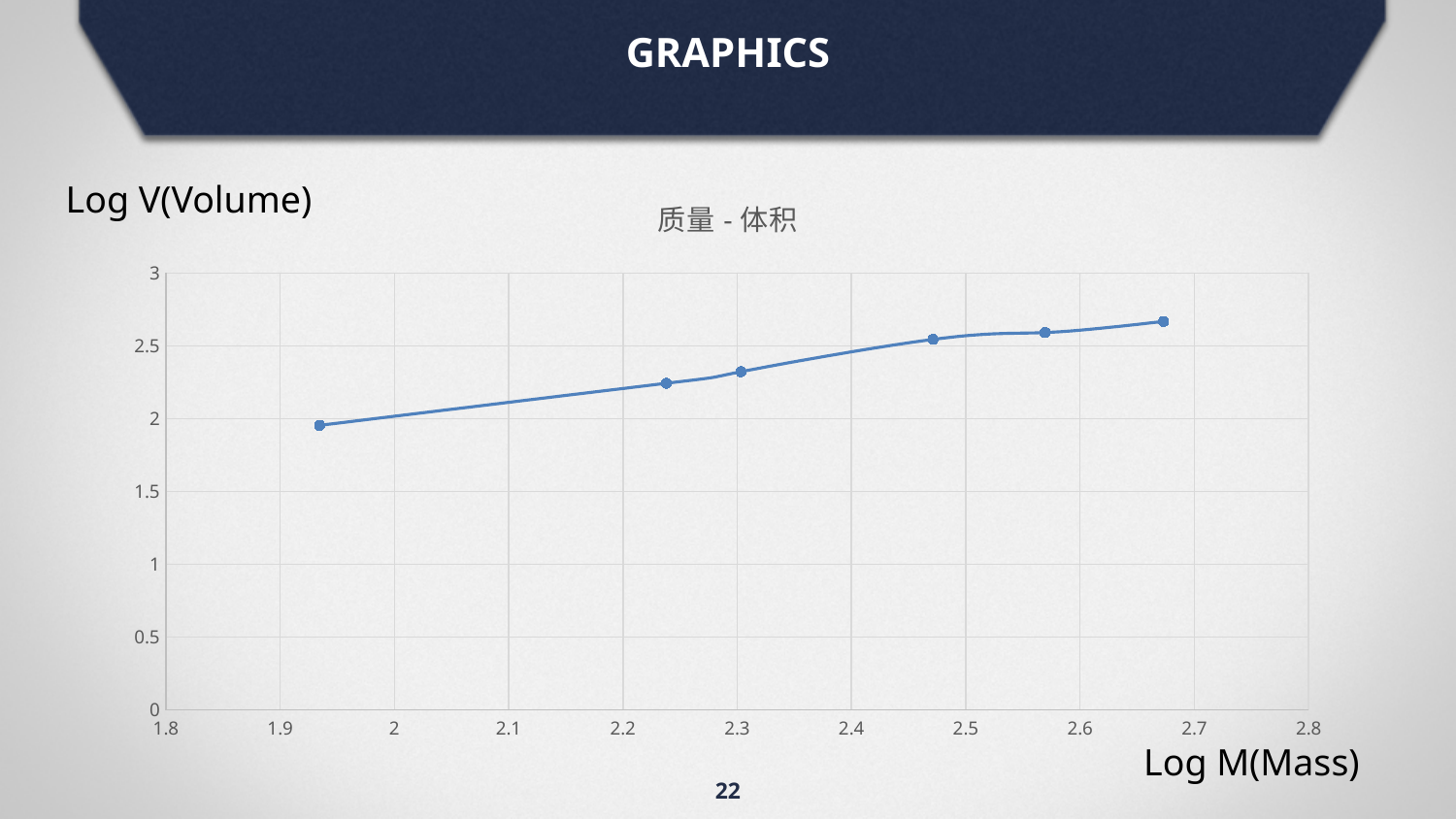
What kind of chart is shown on the slide? line chart What is the title of the chart? 质量 - 体积 What label is given to the horizontal axis of the chart? Log M(Mass) How many data points are plotted on the chart? 6 Is the Log V value of the leftmost data point greater or less than 2? less Do the plotted values rise or fall as Log M(Mass) increases along the x axis? rise Is the Log M value of the rightmost data point greater or less than 2.7? less Is the Log V value of the data point near Log M = 2.3 greater or less than 2.5? less Which data point has the highest Log V value, the leftmost or the rightmost? the rightmost